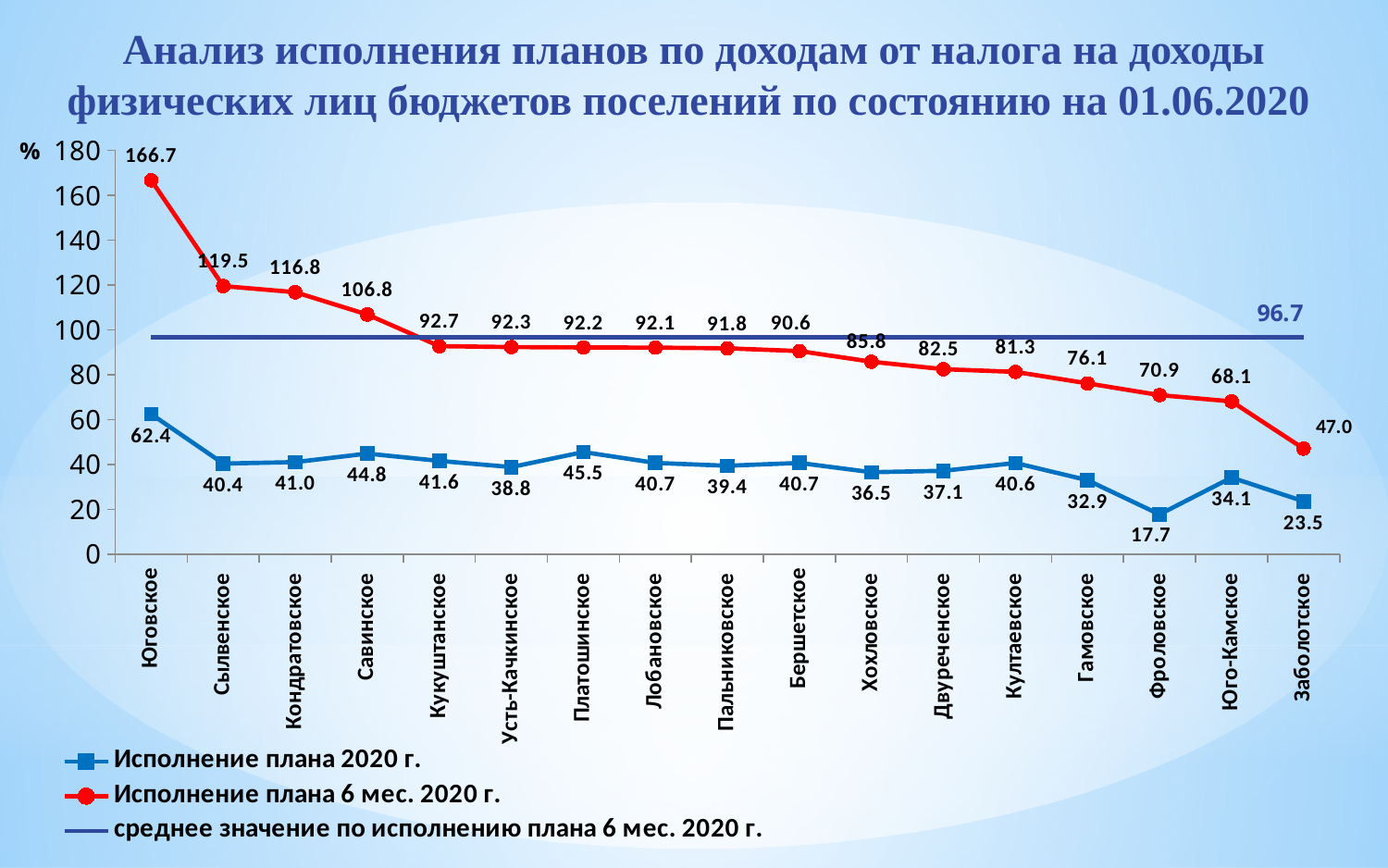
What is the value of 'Исполнение плана 2020 г.' for Фроловское? 17.7 What is the value of 'Исполнение плана 6 мес. 2020 г.' for Юговское? 166.7 What colour is the line for 'Исполнение плана 6 мес. 2020 г.'? red What type of chart is shown on the slide? line chart Which settlement has the highest value for 'Исполнение плана 2020 г.'? Юговское What is the average value shown by the horizontal line ('среднее значение по исполнению плана 6 мес. 2020 г.')? 96.7 Does the 'Исполнение плана 6 мес. 2020 г.' series generally rise or fall from left to right along the x axis? fall Which settlement has the lowest value for 'Исполнение плана 6 мес. 2020 г.'? Заболотское What is the difference between the 'Исполнение плана 6 мес. 2020 г.' values for Сылвенское and Заболотское? 72.5 How many settlements (categories) are shown on the x axis? 17 Which is larger: the 'Исполнение плана 2020 г.' value for Платошинское or for Савинское? Платошинское How many entries does the legend list? 3